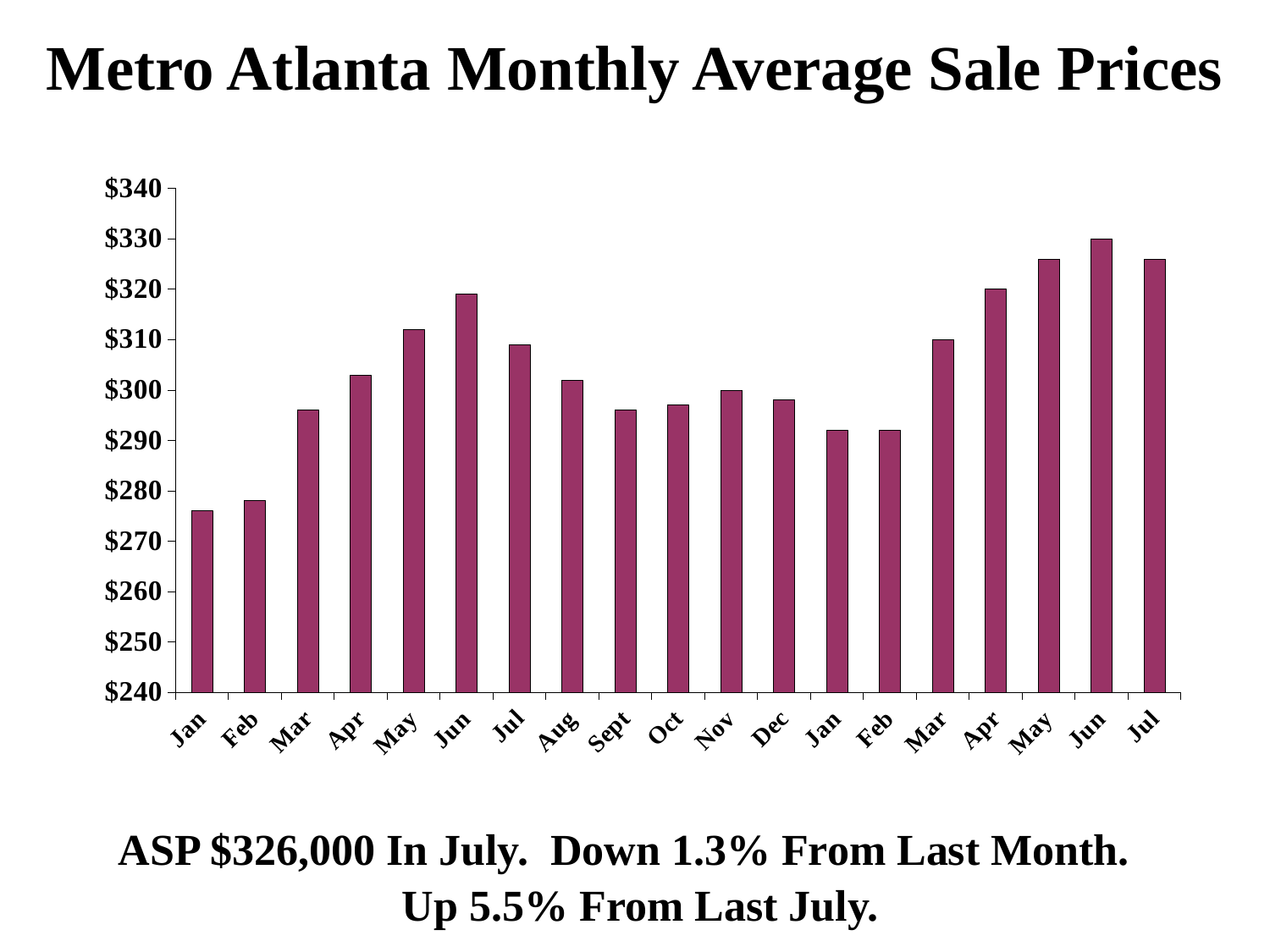
Which is larger, the first Jun bar or the first Jul bar? the first Jun bar Which month has the highest bar in the chart? Jun (the second Jun, second from the right) According to the caption below the chart, what was the ASP in July? $326,000 How many monthly bars are plotted in the chart? 19 What type of chart is shown on the slide? bar chart Which month has the lowest bar in the chart? Jan (the leftmost bar) What is the title of the chart? Metro Atlanta Monthly Average Sale Prices Is the value for Sept greater or less than $300? less Is the value for the second May bar greater or less than $320? greater Is the value for the leftmost Jan bar greater or less than $280? less Do the bars rise or fall from the second Jan through the second Jun? rise